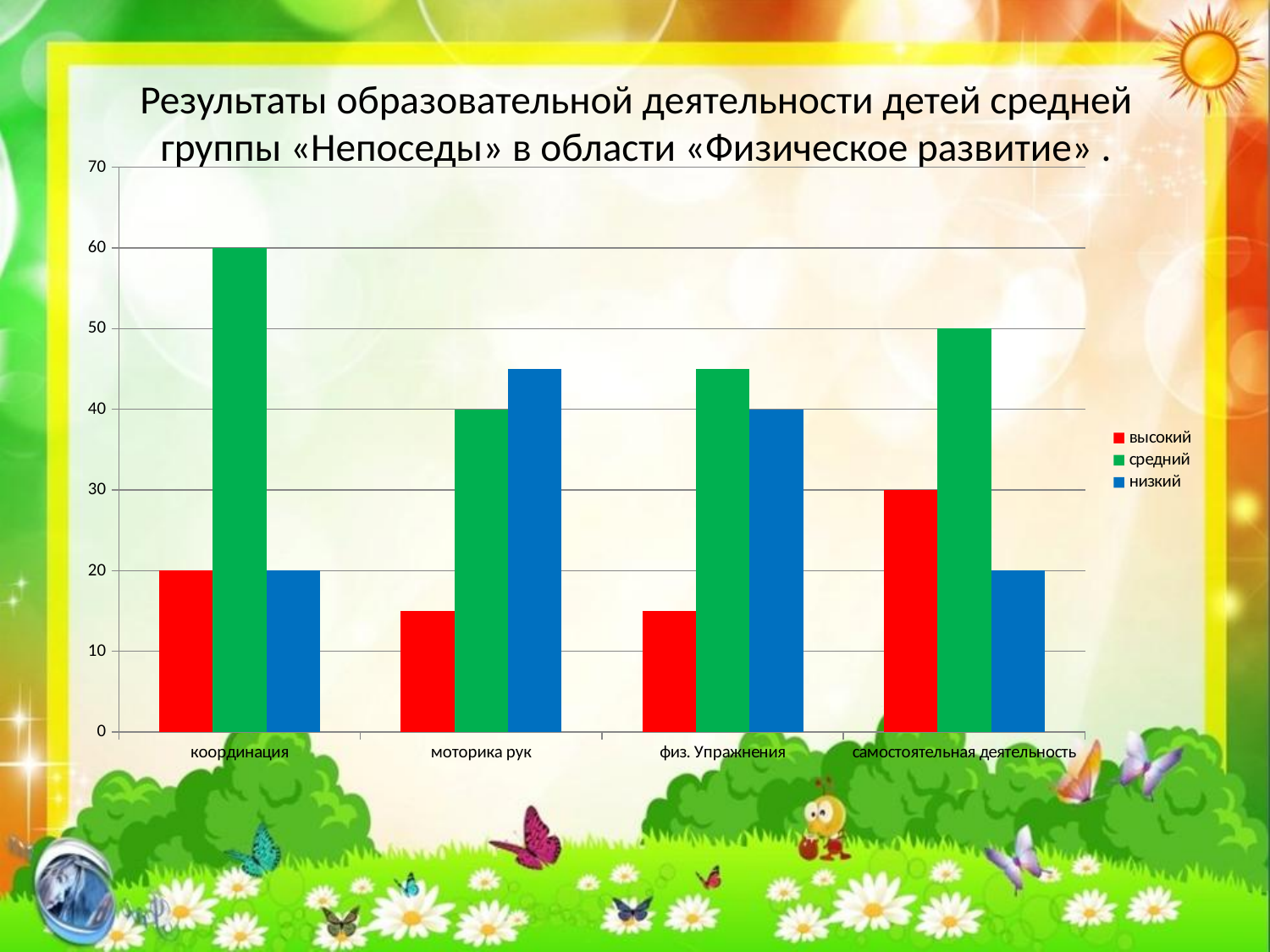
Which category has the highest средний value? координация What is the value of the низкий bar for физ. Упражнения? 40 What is the value of the средний bar for координация? 60 How many series does the legend list? 3 Which category has the lowest средний value? моторика рук For самостоятельная деятельность, which is larger: the высокий bar or the низкий bar? высокий What is the value of the высокий bar for самостоятельная деятельность? 30 What is the difference between the средний and высокий values for координация? 40 What type of chart is shown on the slide? bar chart How many categories are shown on the x axis? 4 What is the value of the средний bar for моторика рук? 40 Is the value of the низкий bar for моторика рук greater or less than 40? greater